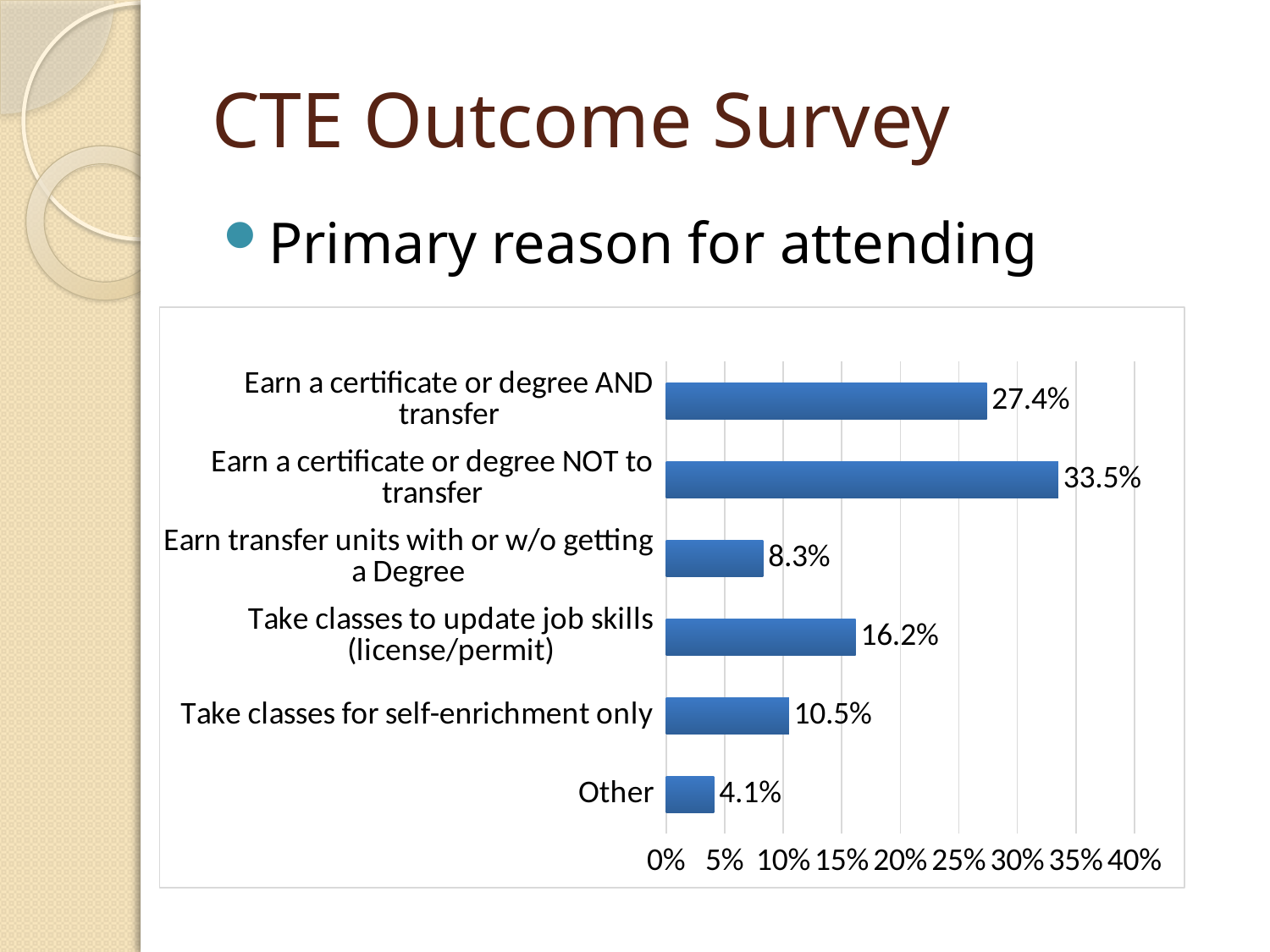
What kind of chart is shown on the slide? Bar chart What percentage is shown for 'Other'? 4.1% Is the value for 'Earn a certificate or degree AND transfer' greater or less than 25%? greater What percentage of respondents chose 'Earn a certificate or degree NOT to transfer' as their primary reason for attending? 33.5% Which primary reason for attending has the lowest percentage? Other Which primary reason for attending has the highest percentage? Earn a certificate or degree NOT to transfer Which is larger: 'Earn transfer units with or w/o getting a Degree' or 'Take classes for self-enrichment only'? Take classes for self-enrichment only What is the value for 'Take classes for self-enrichment only'? 10.5% What is the maximum value shown on the chart's percentage axis? 40% How many categories (reasons for attending) are shown in the chart? 6 What is the difference between 'Earn a certificate or degree NOT to transfer' and 'Earn a certificate or degree AND transfer'? 6.1% What is the value shown for 'Take classes to update job skills (license/permit)'? 16.2%